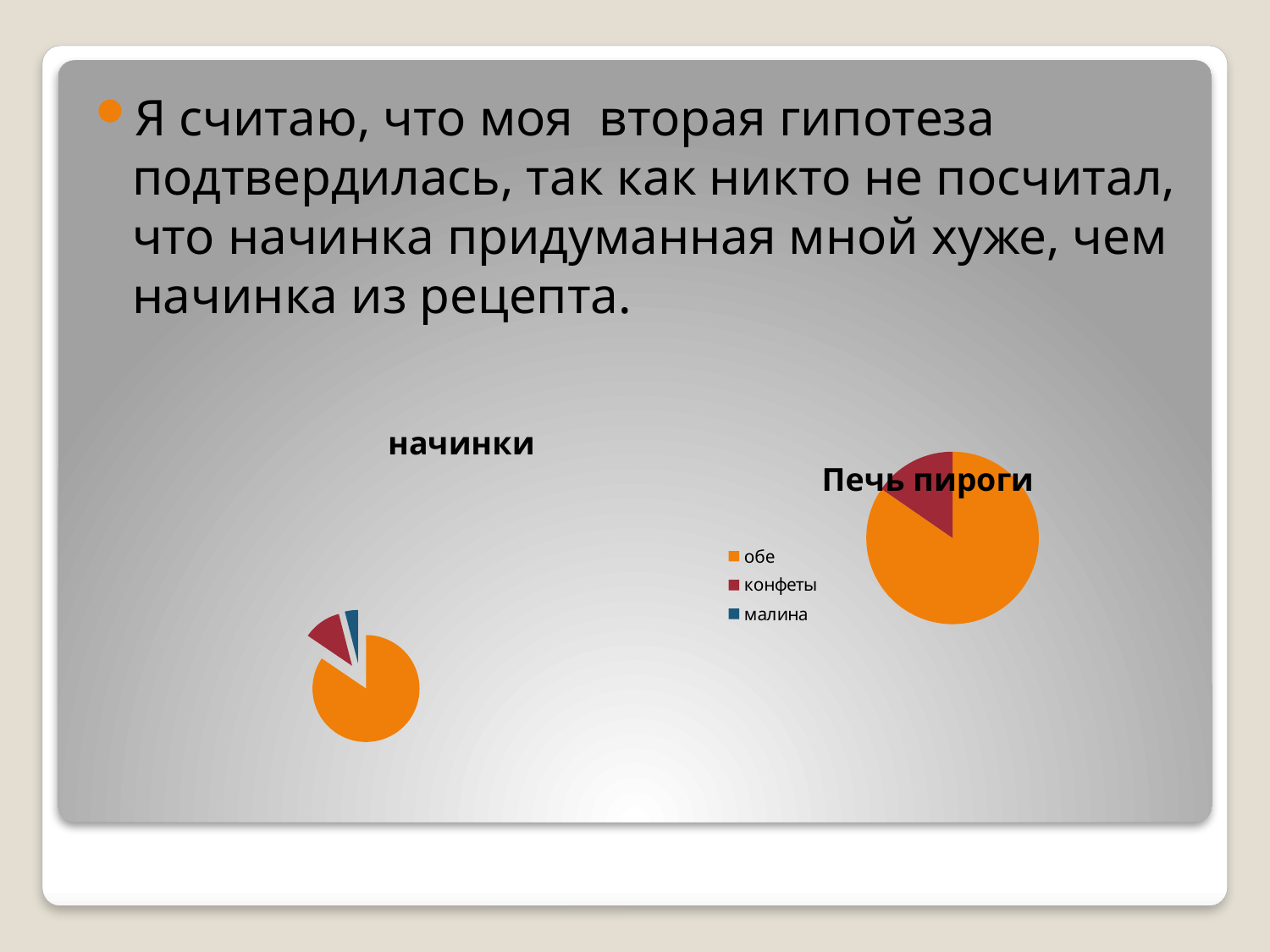
In the chart titled "начинки", which slice is larger: конфеты or малина? конфеты What kind of chart is the chart titled "Печь пироги"? pie chart In the chart titled "начинки", which slice is larger: обе or конфеты? обе What kind of chart is the chart titled "начинки"? pie chart In the chart titled "начинки", how many entries does the legend list? 3 In the chart titled "Печь пироги", which colour slice is larger: orange or red? orange In the chart titled "начинки", which category has the smallest slice? малина How many slices does the chart titled "начинки" have? 3 How many slices does the chart titled "Печь пироги" have? 2 In the chart titled "начинки", which category has the largest slice? обе What is the title of the pie chart on the right side of the slide? Печь пироги In the chart titled "начинки", what colour is the slice for малина? blue